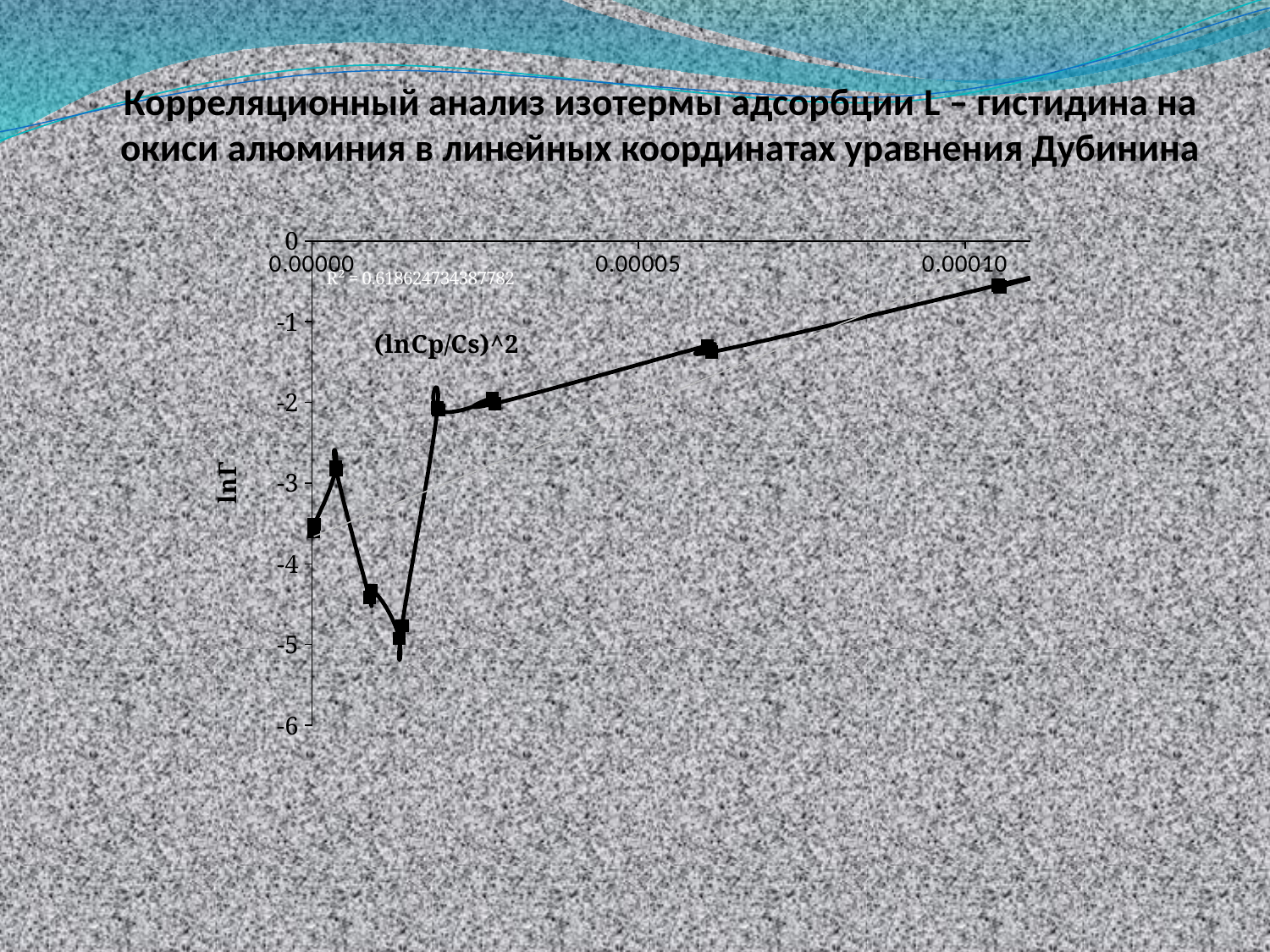
What is the lowest tick value shown on the vertical axis? -6 Is the point near x = 0.00006 greater or less than -2? greater What kind of chart is shown on the slide? line chart Which point is higher: the one near x = 0.00010 or the one near x = 0.00006? the one near x = 0.00010 Is the rightmost point on the chart (near x = 0.00010) greater or less than -1? greater Is the first point at x = 0.00000 greater or less than -3? less What is the label of the horizontal axis? (lnCp/Cs)^2 What is the largest tick value shown on the horizontal axis? 0.00010 Do the values rise or fall along the x axis from about 0.00002 to 0.00010? rise What is the label of the vertical axis? lnГ